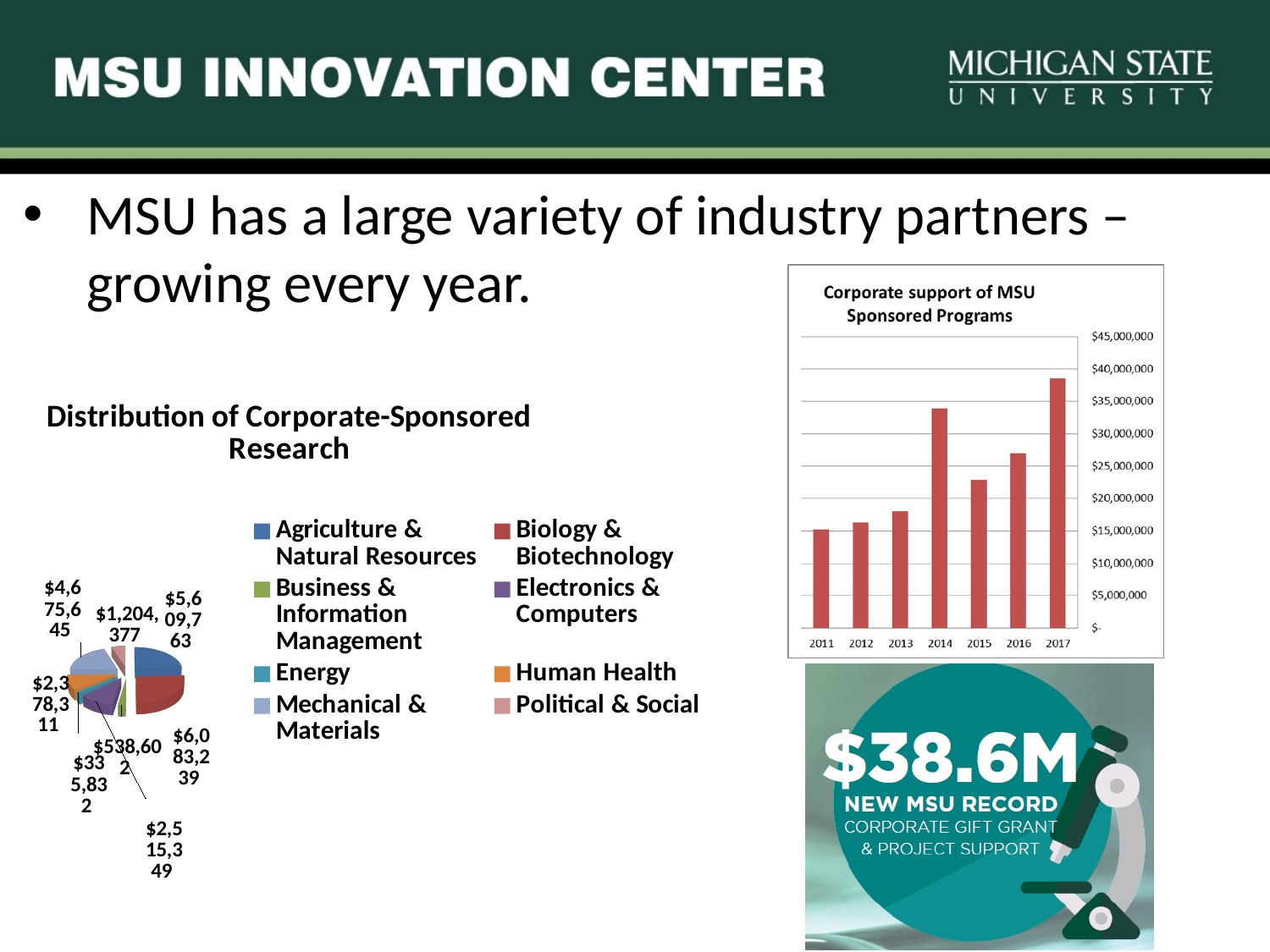
In the 'Corporate support of MSU Sponsored Programs' chart, is the value for 2011 greater or less than $20,000,000? less What kind of chart is the 'Corporate support of MSU Sponsored Programs' chart? bar chart What kind of chart is the 'Distribution of Corporate-Sponsored Research' chart? pie chart In the 'Corporate support of MSU Sponsored Programs' chart, which year has the larger value, 2014 or 2015? 2014 In the 'Corporate support of MSU Sponsored Programs' chart, do the values rise or fall from 2011 to 2014? rise In the 'Corporate support of MSU Sponsored Programs' chart, is the value for 2014 greater or less than $30,000,000? greater In the 'Corporate support of MSU Sponsored Programs' chart, is the value for 2017 greater or less than $35,000,000? greater How many categories does the legend of the 'Distribution of Corporate-Sponsored Research' pie chart list? 8 In the 'Corporate support of MSU Sponsored Programs' chart, which year has the highest value? 2017 In the 'Corporate support of MSU Sponsored Programs' chart, how many years are shown on the x axis? 7 In the 'Corporate support of MSU Sponsored Programs' chart, which year has the lowest value? 2011